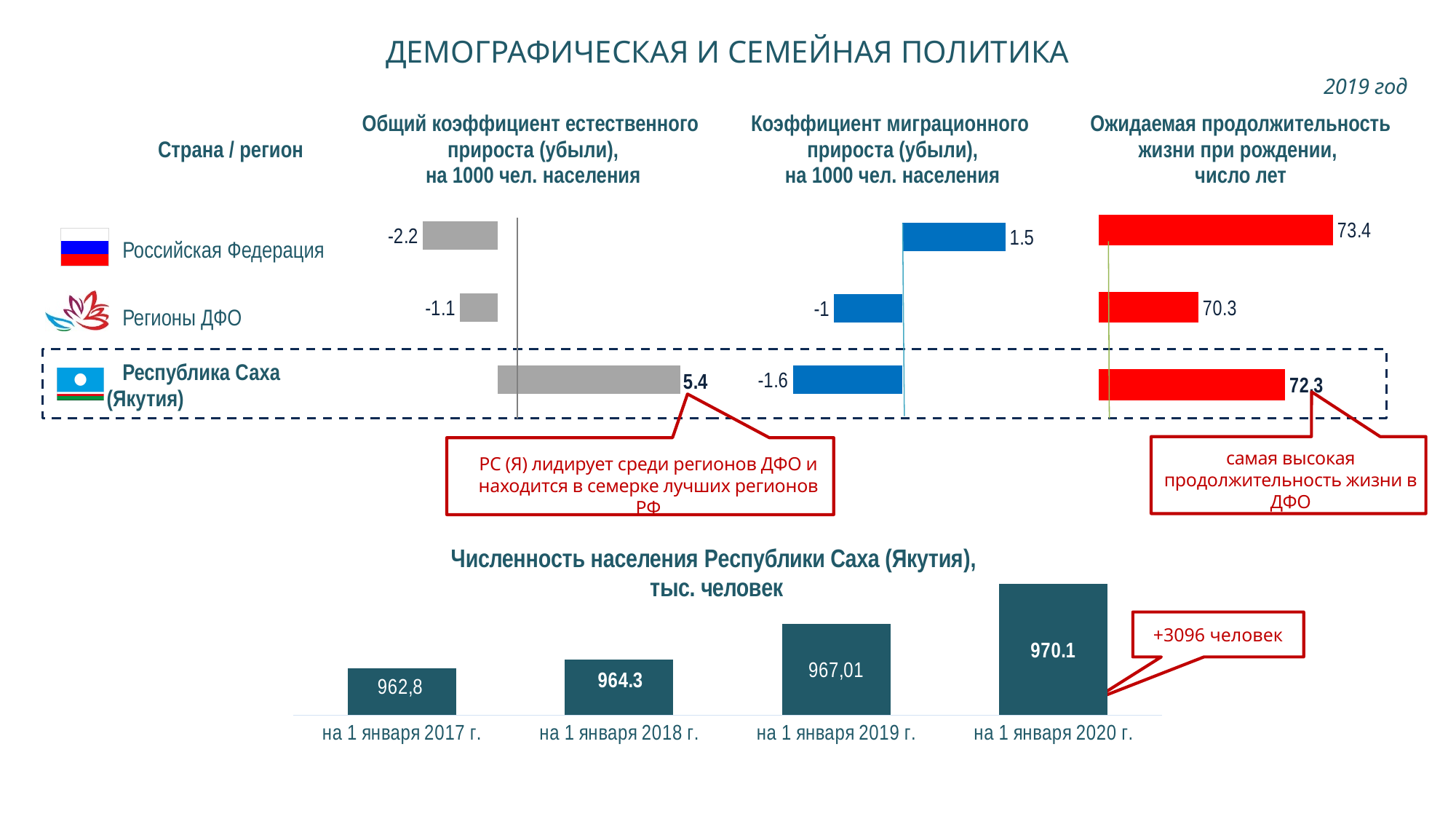
What type of chart is 'Численность населения Республики Саха (Якутия), тыс. человек'? bar chart In the chart 'Коэффициент миграционного прироста (убыли), на 1000 чел. населения', which region has the lowest value? Республика Саха (Якутия) In the chart 'Общий коэффициент естественного прироста (убыли), на 1000 чел. населения', what is the value for Республика Саха (Якутия)? 5.4 In the chart 'Ожидаемая продолжительность жизни при рождении, число лет', which region has the highest value? Российская Федерация In the chart 'Численность населения Республики Саха (Якутия), тыс. человек', what is the value for 'на 1 января 2020 г.'? 970.1 In the chart 'Ожидаемая продолжительность жизни при рождении, число лет', what is the difference between Российская Федерация and Республика Саха (Якутия)? 1.1 In the chart 'Численность населения Республики Саха (Якутия), тыс. человек', how many bars are shown? 4 In the chart 'Численность населения Республики Саха (Якутия), тыс. человек', what is the value for 'на 1 января 2019 г.'? 967,01 In the chart 'Коэффициент миграционного прироста (убыли), на 1000 чел. населения', what is the value for Регионы ДФО? -1 In the chart 'Численность населения Республики Саха (Якутия), тыс. человек', do the values rise or fall from 2017 to 2020? rise In the chart 'Общий коэффициент естественного прироста (убыли), на 1000 чел. населения', what is the value for Российская Федерация? -2.2 In the chart 'Ожидаемая продолжительность жизни при рождении, число лет', what is the value for Регионы ДФО? 70.3